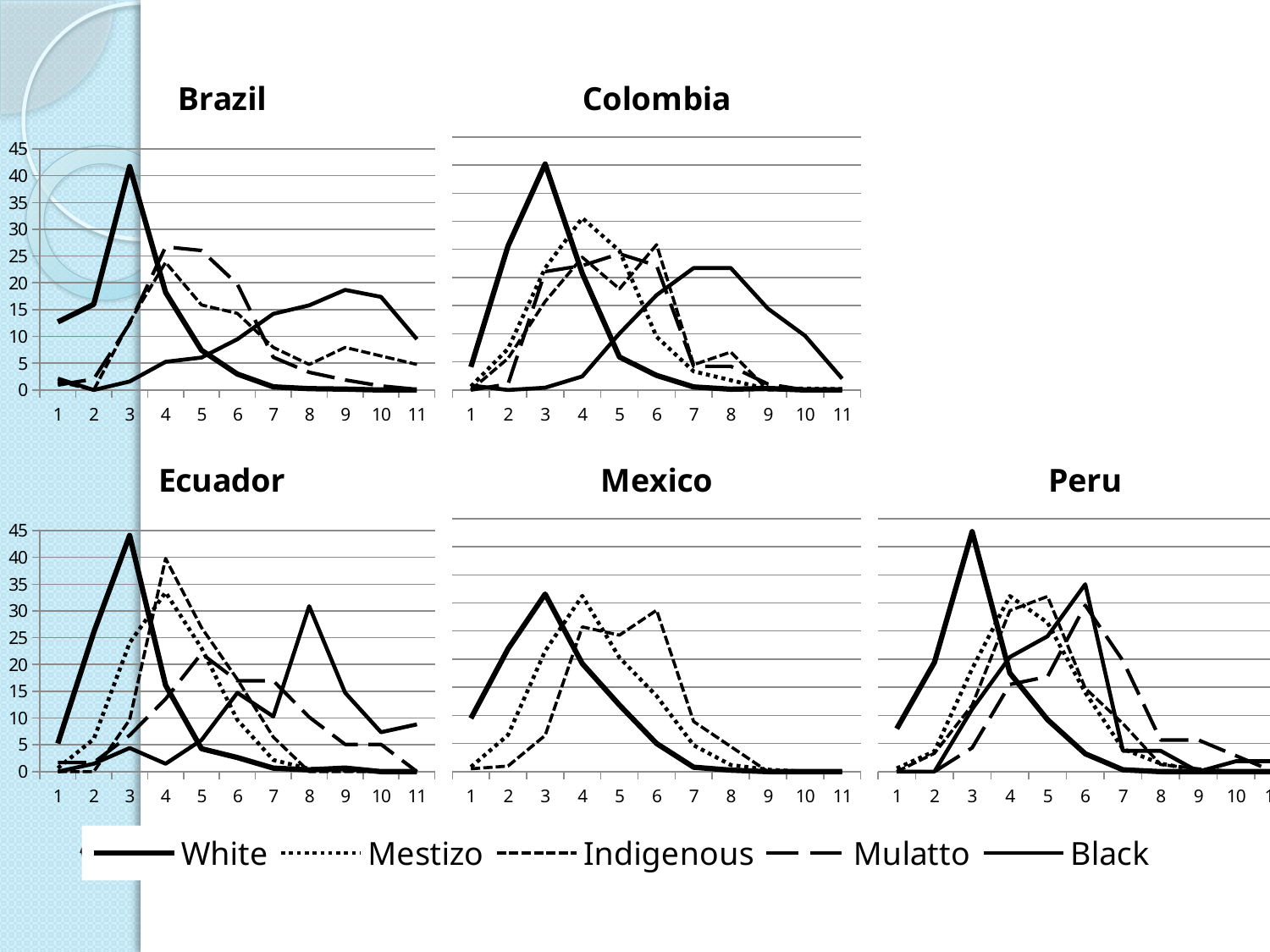
In the Ecuador chart, is the value for Black at x = 8 greater or less than 25? greater What kind of chart is the Brazil chart? line chart In the Brazil chart, does the White series rise or fall from x = 3 to x = 11? fall In the Brazil chart, at x = 3, which is larger: White or Black? White In the Ecuador chart, is the value for Indigenous at x = 4 greater or less than 35? greater How many charts are shown on the slide? 5 How many points are on the x axis of the Brazil chart? 11 In the Ecuador chart, which series reaches the highest peak? White How many series does the legend list? 5 In the Ecuador chart, is the value for White at x = 1 greater or less than 10? less In the Brazil chart, at which x value does the White series reach its highest point? 3